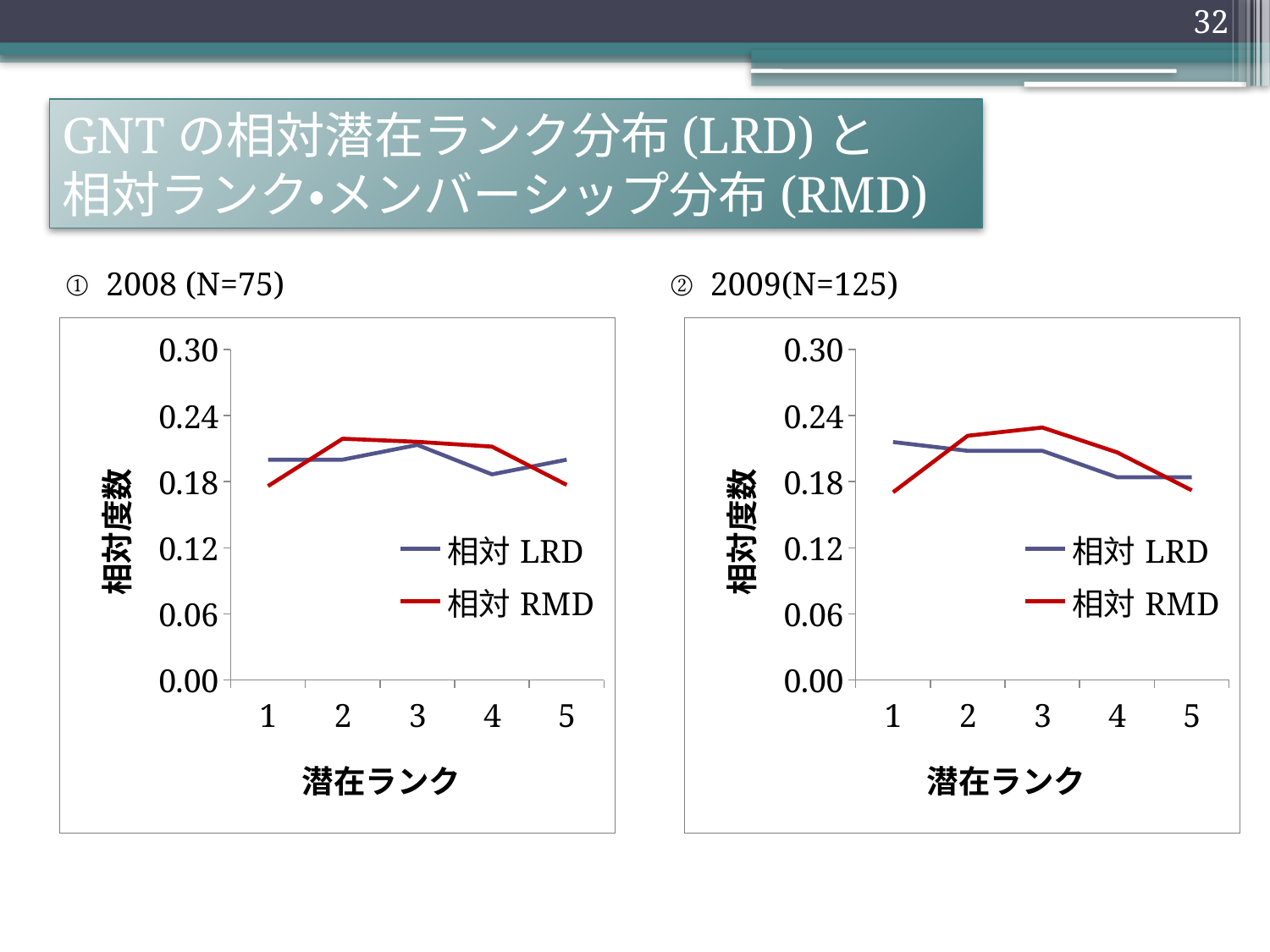
What kind of chart is the 2008 (N=75) chart on the left? line chart In the 2008 (N=75) chart, which series has the larger value at 潜在ランク 1, 相対 LRD or 相対 RMD? 相対 LRD In the 2009 (N=125) chart, which series has the larger value at 潜在ランク 1, 相対 LRD or 相対 RMD? 相対 LRD In the 2009 (N=125) chart, is the 相対 RMD value at 潜在ランク 5 greater or less than 0.18? less How many series does the legend of the 2009 (N=125) chart list? 2 In the 2008 (N=75) chart, is the 相対 RMD value at 潜在ランク 2 greater or less than 0.18? greater In the 2009 (N=125) chart, at which 潜在ランク is the 相対 RMD value highest? 3 What is the y-axis title of the 2008 (N=75) chart? 相対度数 In the 2009 (N=125) chart, which series has the larger value at 潜在ランク 3, 相対 LRD or 相対 RMD? 相対 RMD How many 潜在ランク categories are shown on the x axis of the 2008 (N=75) chart? 5 In the 2009 (N=125) chart, is the 相対 LRD value at 潜在ランク 1 greater or less than 0.18? greater